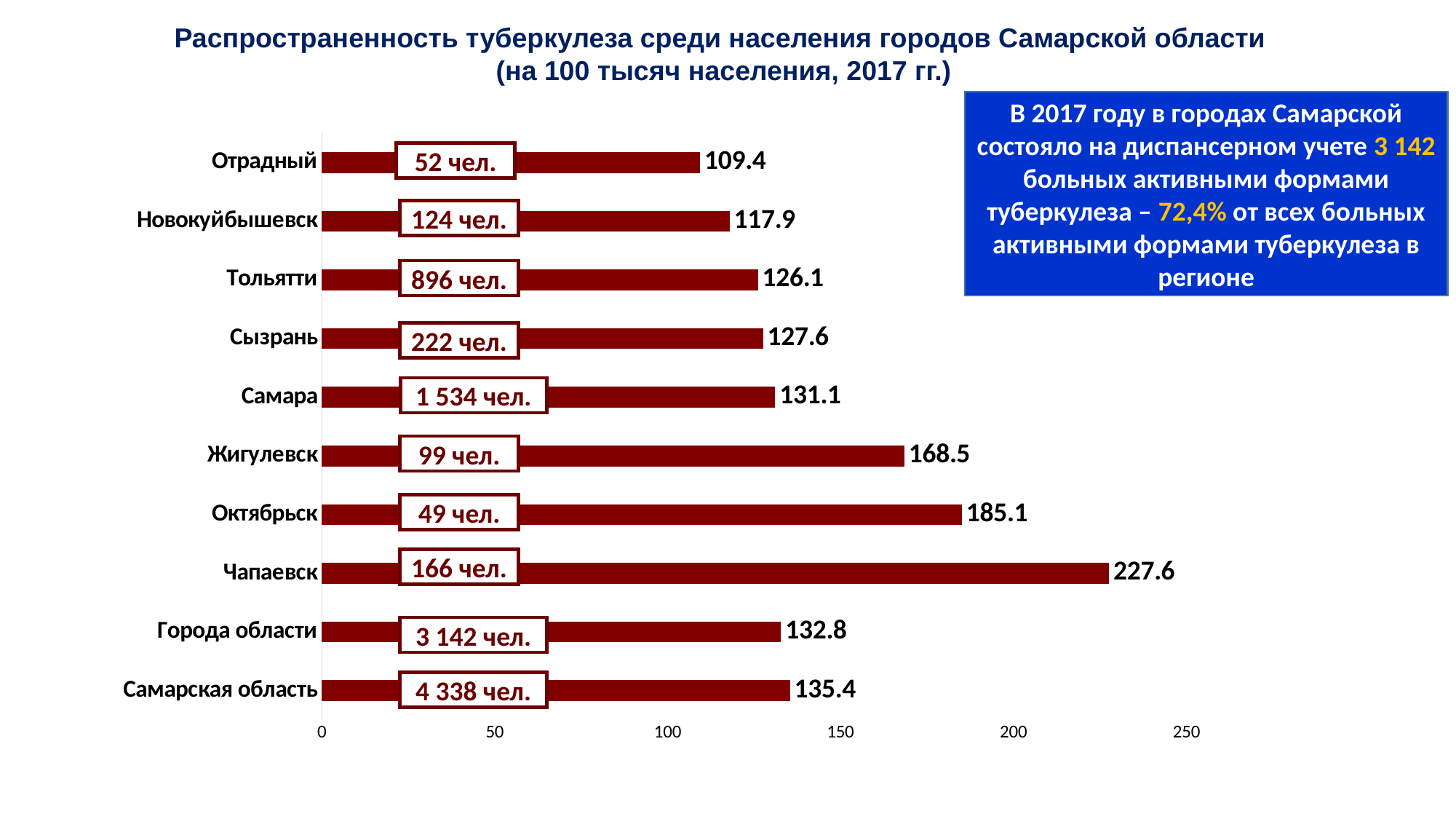
How many categories are shown on the chart? 10 Which category has the lowest value on the chart? Отрадный What is the value shown for Самарская область? 135.4 Which has a larger value, Октябрьск or Жигулевск? Октябрьск What is the value shown for Чапаевск? 227.6 How many people (чел.) are shown in the label for Тольятти? 896 чел. What is the tuberculosis prevalence value shown for Самара? 131.1 What year does the chart title say the data refers to? 2017 What type of chart is shown on the slide? bar chart Which category has the highest value on the chart? Чапаевск What is the difference between the values for Чапаевск and Отрадный? 118.2 Is the value for Новокуйбышевск greater or less than 150? less